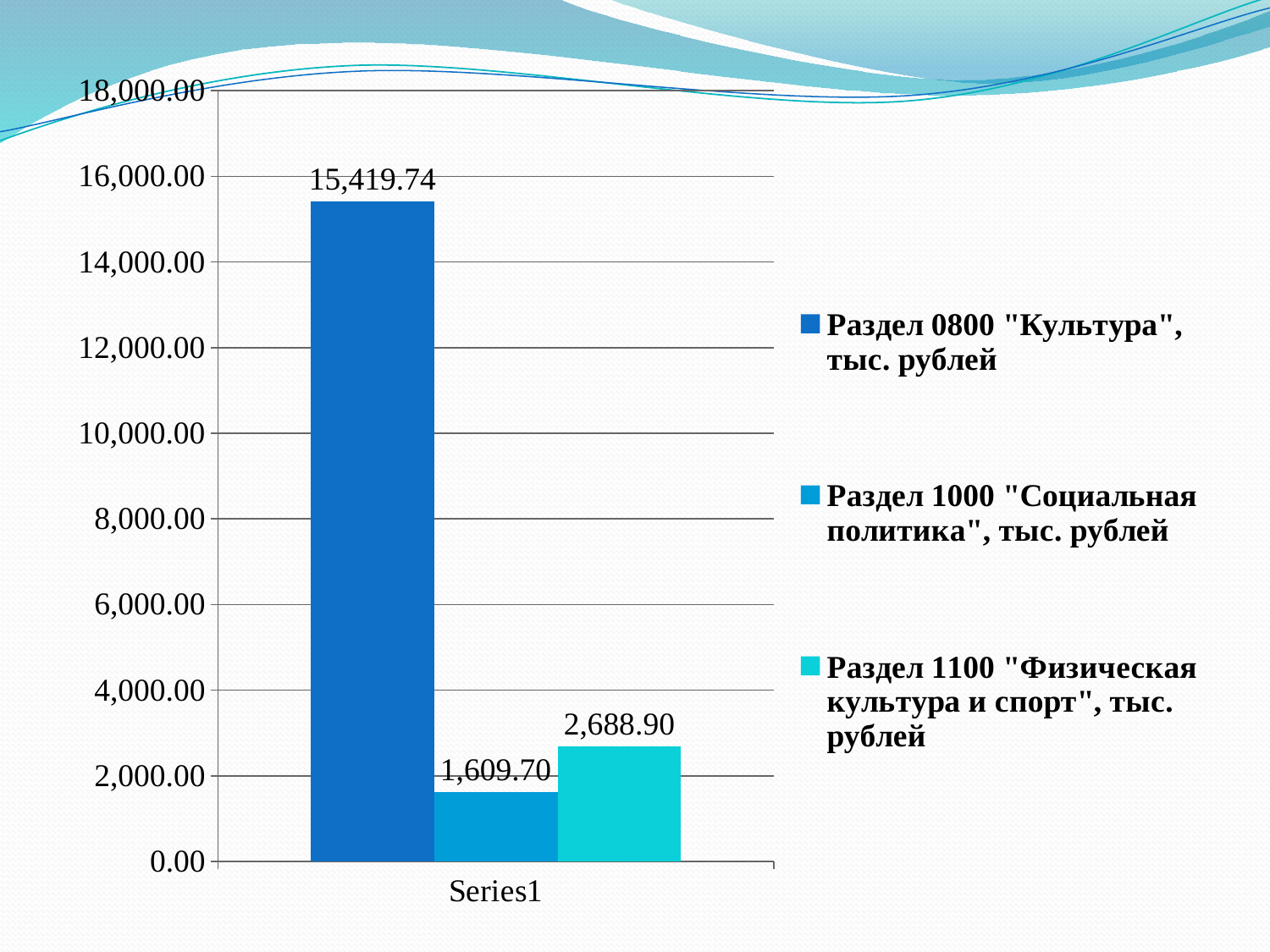
What is the label on the x axis under the bars? Series1 How many series does the legend list? 3 Is the value for Раздел 0800 "Культура" greater or less than 14,000.00? greater Which is larger, the value for Раздел 1100 "Физическая культура и спорт" or the value for Раздел 1000 "Социальная политика"? Раздел 1100 "Физическая культура и спорт" Which series has the lowest value? Раздел 1000 "Социальная политика", тыс. рублей What is the value for Раздел 1100 "Физическая культура и спорт"? 2,688.90 What is the value for Раздел 0800 "Культура"? 15,419.74 What kind of chart is shown on the slide? bar chart Which series has the highest value? Раздел 0800 "Культура", тыс. рублей What is the difference between the values for Раздел 1100 "Физическая культура и спорт" and Раздел 1000 "Социальная политика"? 1,079.20 What is the value for Раздел 1000 "Социальная политика"? 1,609.70 What is the difference between the values for Раздел 0800 "Культура" and Раздел 1000 "Социальная политика"? 13,810.04